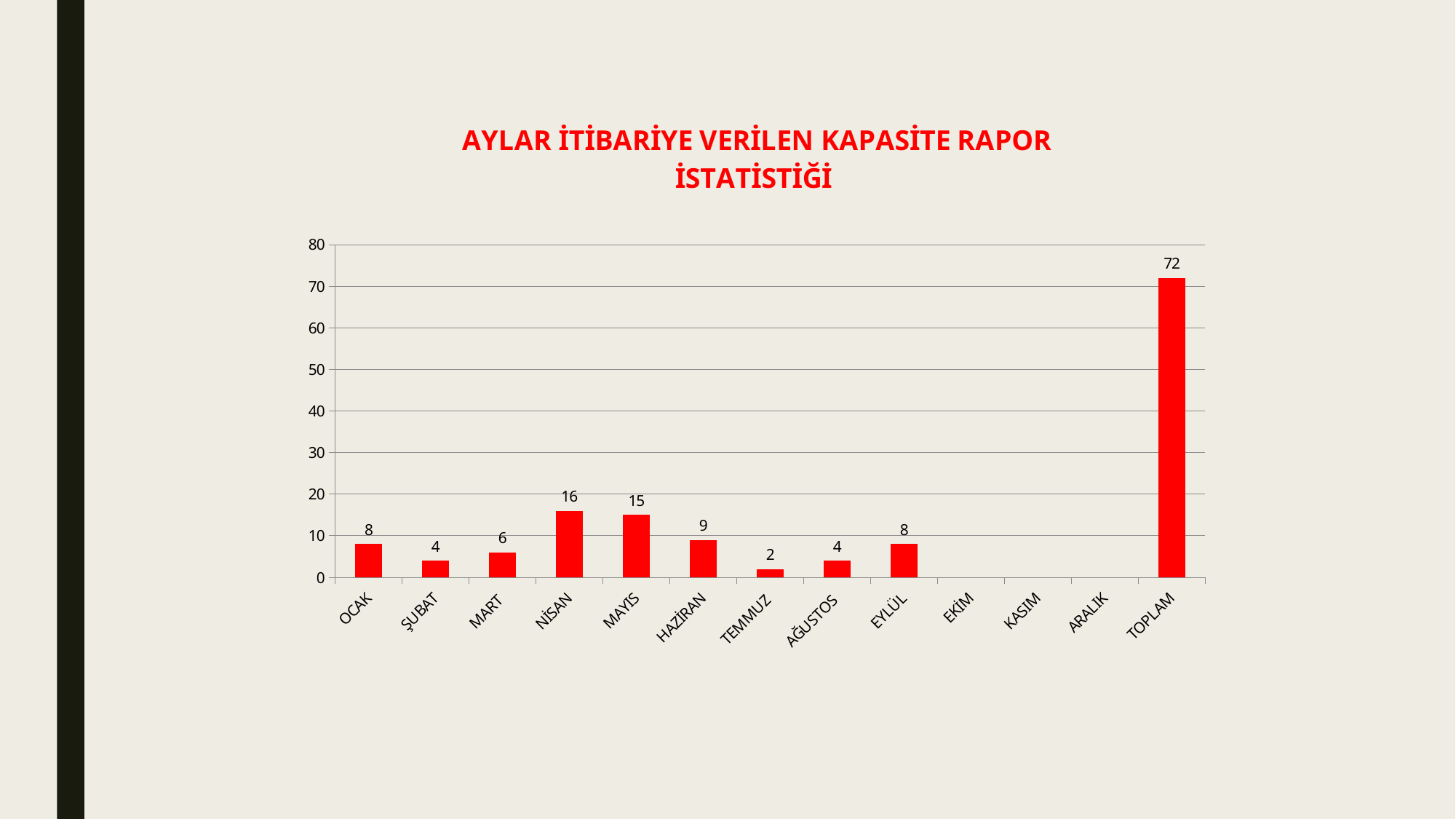
What is the difference between the values for HAZİRAN and ŞUBAT? 5 Is the value for TOPLAM greater or less than 60? greater What is the value for NİSAN? 16 What is the difference between the values for NİSAN and MAYIS? 1 Which is larger, the value for OCAK or the value for MART? OCAK What is the value for TOPLAM? 72 What kind of chart is shown on the slide? bar chart Among the months with a visible bar, which has the lowest value? TEMMUZ Which month (excluding TOPLAM) has the highest value? NİSAN How many categories are shown on the x axis? 13 What is the value for TEMMUZ? 2 What is the title of the chart? AYLAR İTİBARİYE VERİLEN KAPASİTE RAPOR İSTATİSTİĞİ